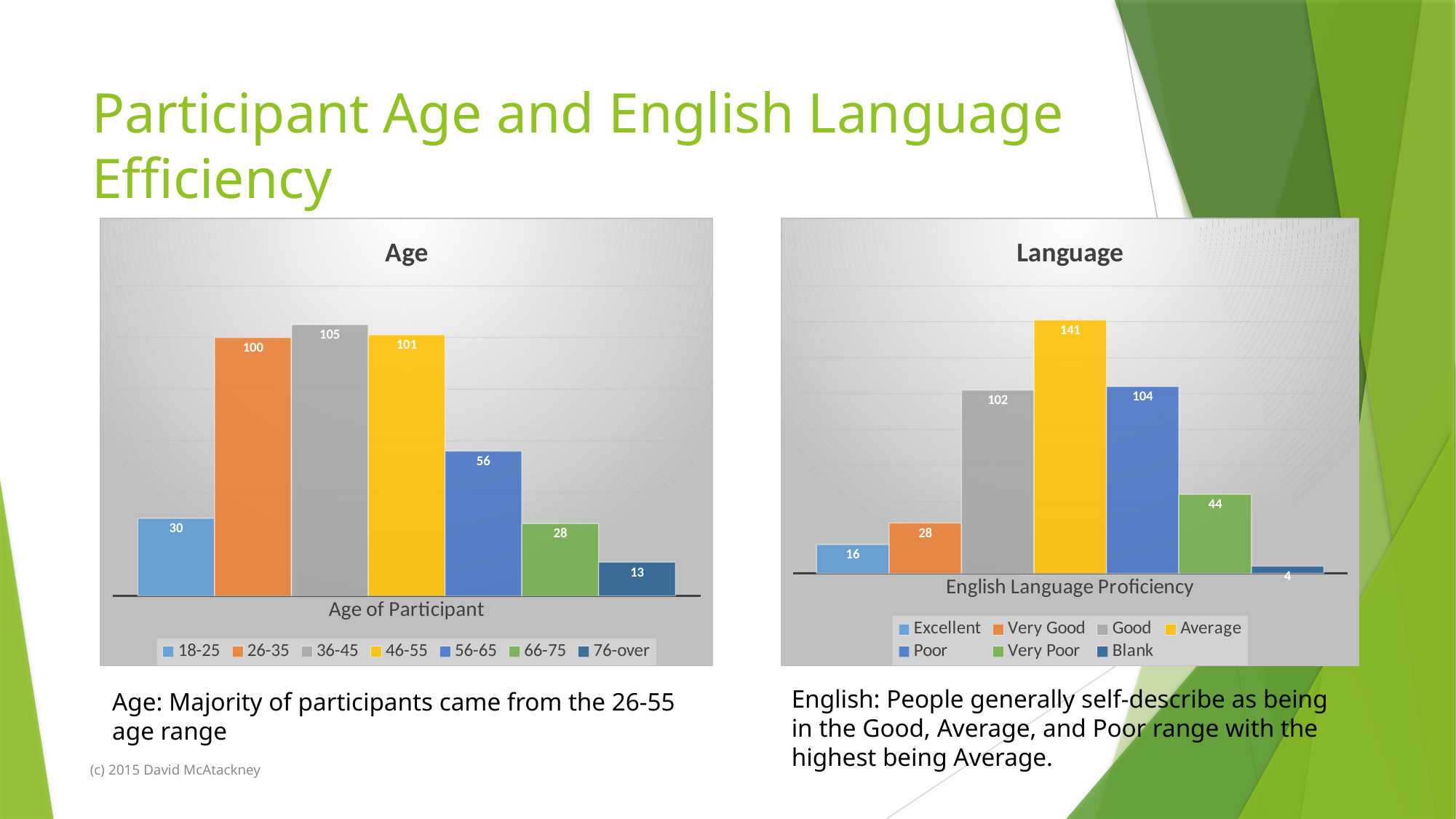
In the Age chart, what is the difference between the values for 46-55 and 56-65? 45 In the Language chart, what colour is the bar for Very Poor? Green In the Age chart, how many age groups are plotted? 7 In the Language chart, what is the value for Blank? 4 What kind of chart is the Language chart? Bar chart In the Language chart, what is the value for Average? 141 In the Language chart, which proficiency level has the highest value? Average In the Age chart, what is the value for the 36-45 age group? 105 In the Language chart, what is the difference between the values for Poor and Good? 2 In the Language chart, how many entries does the legend list? 7 In the Age chart, which age group has the lowest value? 76-over In the Age chart, which is larger: the value for 18-25 or the value for 66-75? 18-25